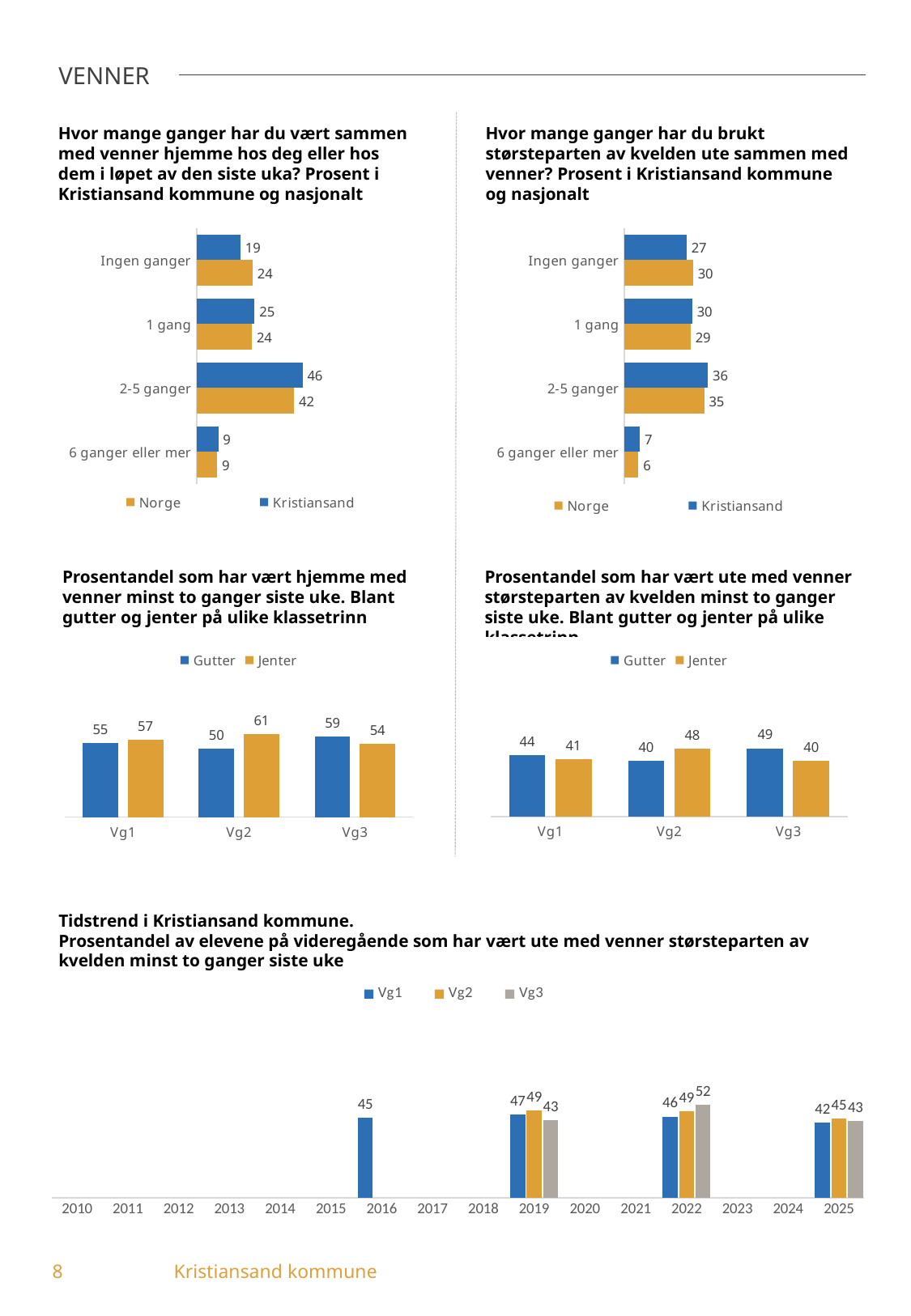
In the middle-right chart (ute med venner størsteparten av kvelden minst to ganger), what is the value for Gutter at Vg3? 49 In the top-left chart (venner hjemme hos deg eller hos dem), what is the value for Kristiansand in the '2-5 ganger' category? 46 In the top-right chart (størsteparten av kvelden ute sammen med venner), which category has the lowest value for Kristiansand? 6 ganger eller mer In the top-right chart (størsteparten av kvelden ute sammen med venner), what is the value for Norge in the '1 gang' category? 29 In the top-left chart (venner hjemme hos deg eller hos dem), what is the difference between Kristiansand and Norge for '2-5 ganger'? 4 In the top-right chart (størsteparten av kvelden ute sammen med venner), how many categories are shown? 4 In the middle-right chart (ute med venner størsteparten av kvelden minst to ganger), what is the difference between Jenter and Gutter at Vg2? 8 In the bottom chart (Tidstrend i Kristiansand kommune), what is the value for Vg3 in 2022? 52 In the top-left chart (venner hjemme hos deg eller hos dem), what is the value for Norge in the 'Ingen ganger' category? 24 In the bottom chart (Tidstrend i Kristiansand kommune), how many series does the legend list? 3 In the middle-left chart (hjemme med venner minst to ganger siste uke), what is the value for Jenter at Vg2? 61 In the middle-left chart (hjemme med venner minst to ganger siste uke), which is larger at Vg3: Gutter or Jenter? Gutter